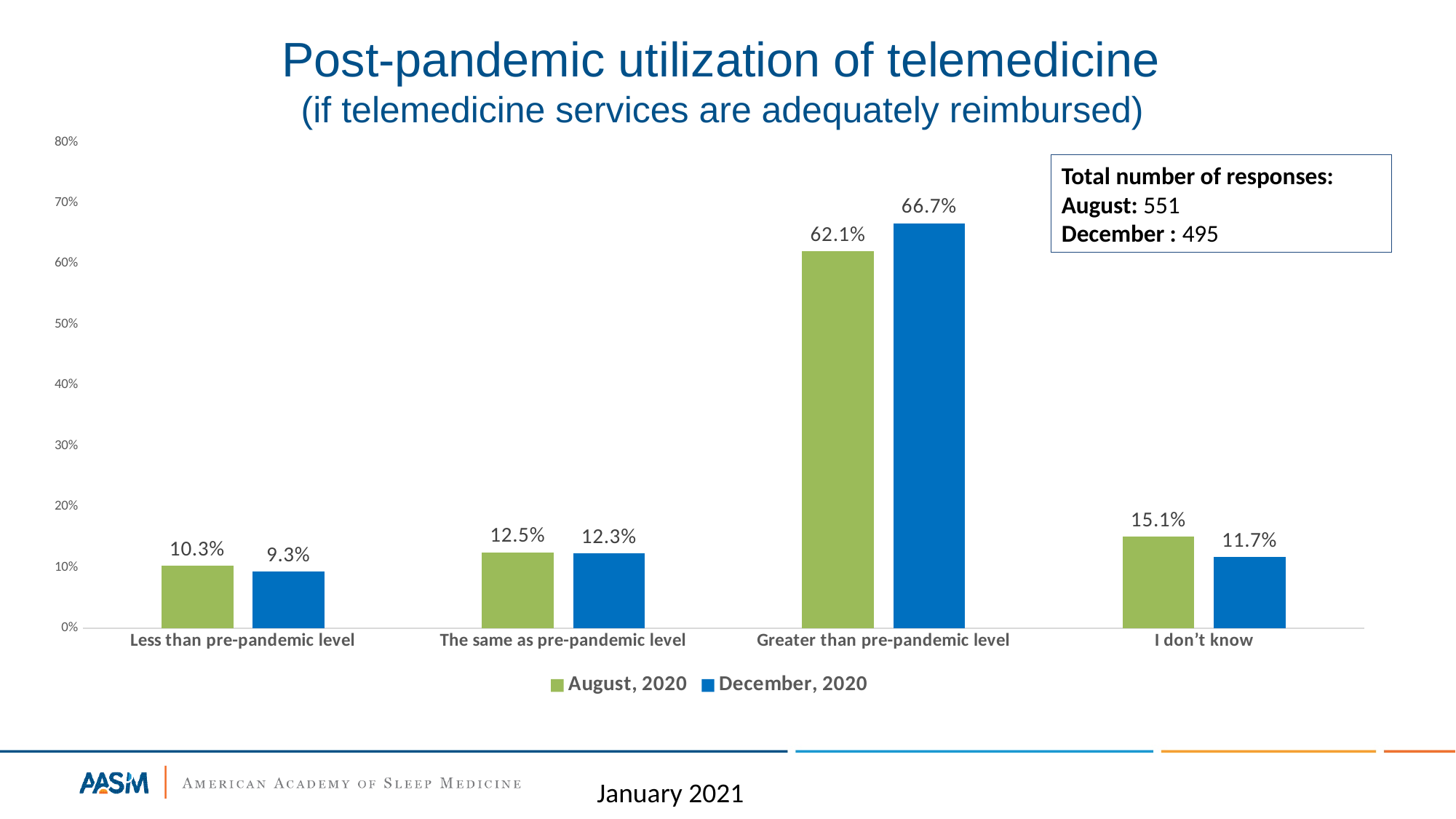
What is the difference between the December, 2020 and August, 2020 values for "Greater than pre-pandemic level"? 4.6% How many categories are shown on the x axis? 4 What is the total number of responses for December shown in the text box? 495 What is the value for "Greater than pre-pandemic level" in the December, 2020 series? 66.7% Which is larger for "I don't know": the August, 2020 value or the December, 2020 value? August, 2020 Which colour represents the December, 2020 series? Blue What kind of chart is shown on the slide? Bar chart Which category has the lowest value in the December, 2020 series? Less than pre-pandemic level What is the value for "I don't know" in the December, 2020 series? 11.7% Which category has the highest value in the August, 2020 series? Greater than pre-pandemic level What is the value for "Less than pre-pandemic level" in the August, 2020 series? 10.3% How many series does the legend list? 2